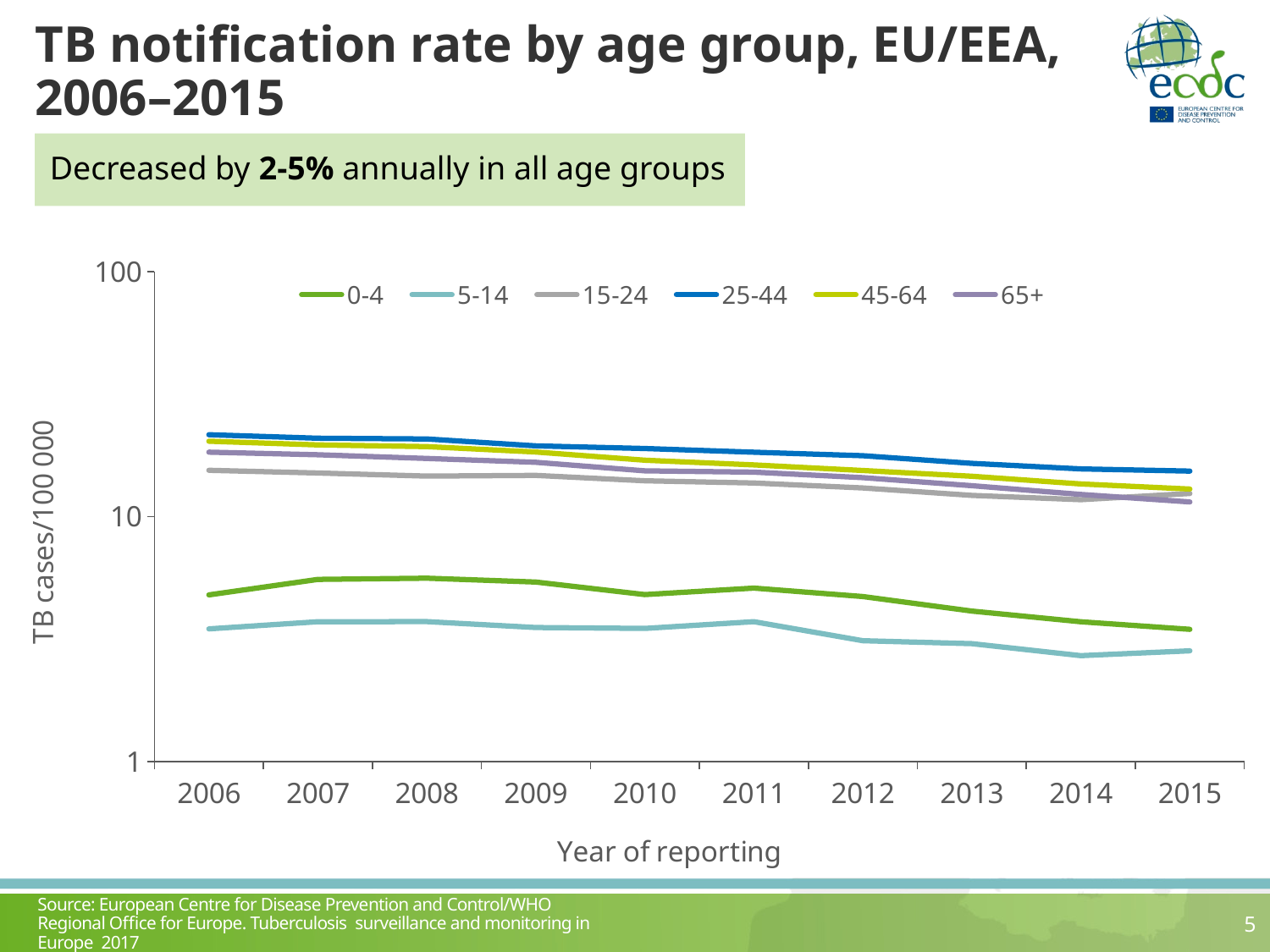
What is the label of the x axis? Year of reporting How many age groups does the legend list? 6 How many years are plotted along the x axis? 10 Is the TB notification rate for the 25-44 age group in 2015 greater or less than 10 cases per 100 000? greater Which age group has the lowest TB notification rate in 2006? 5-14 What kind of chart is shown on the slide? line chart In 2010, which age group has the higher TB notification rate, 25-44 or 0-4? 25-44 Is the TB notification rate for the 5-14 age group in 2015 greater or less than 10 cases per 100 000? less Does the TB notification rate for the 25-44 age group rise or fall from 2006 to 2015? fall Is the TB notification rate for the 0-4 age group in 2006 greater or less than 10 cases per 100 000? less Which age group has the highest TB notification rate in 2015? 25-44 What is the label of the y axis? TB cases/100 000